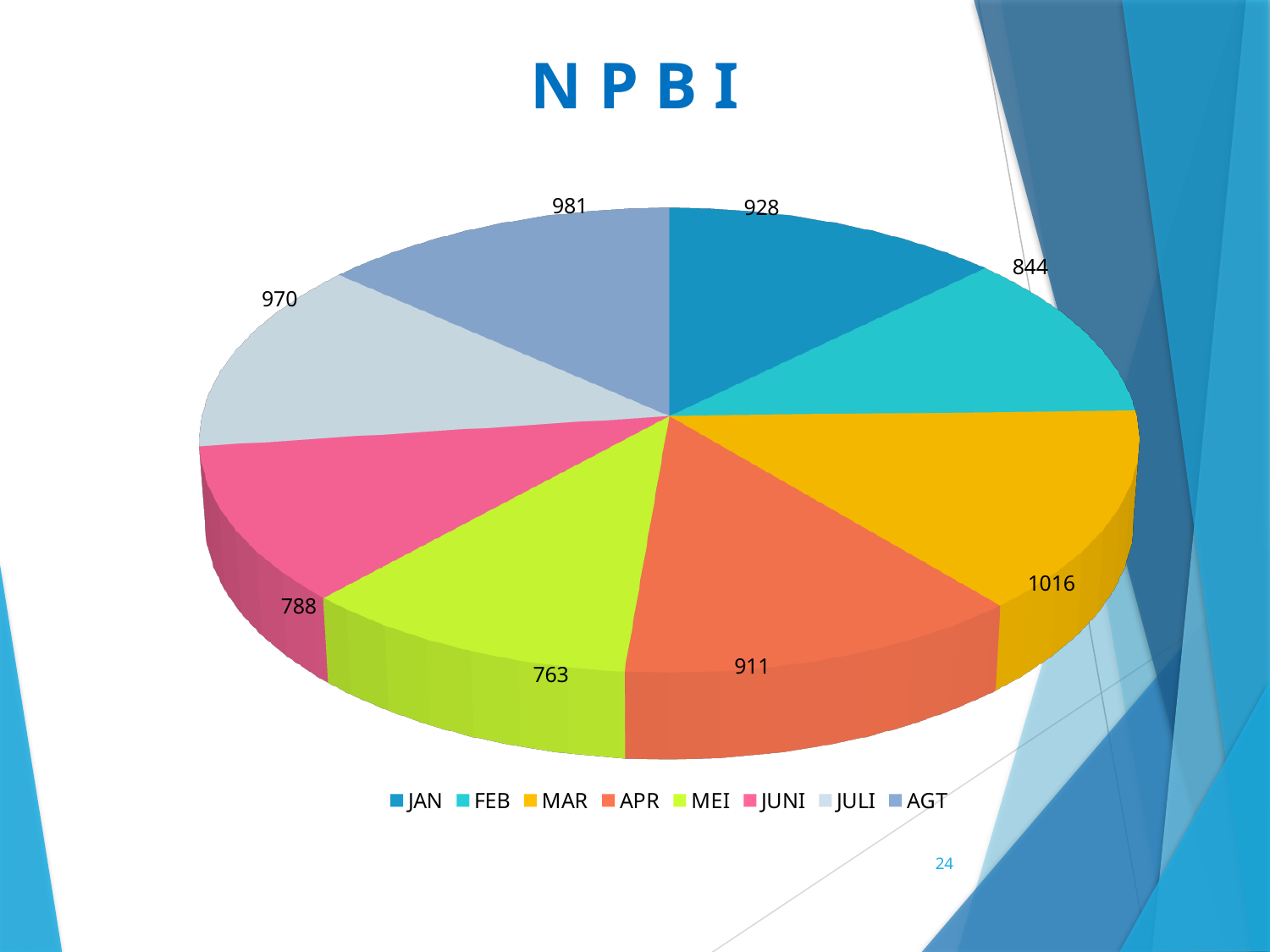
What is the difference between the values for JAN and FEB? 84 Which month has the largest slice? MAR Which is larger, the value for JAN or the value for APR? JAN What kind of chart is shown on the slide? Pie chart What is the value for MAR? 1016 What is the value for FEB? 844 What is the difference between the values for MAR and MEI? 253 Which month has the smallest slice? MEI What is the value for JULI? 970 How many slices does the pie chart have? 8 What is the title of the chart? N P B I What is the total of all the slice values? 7201